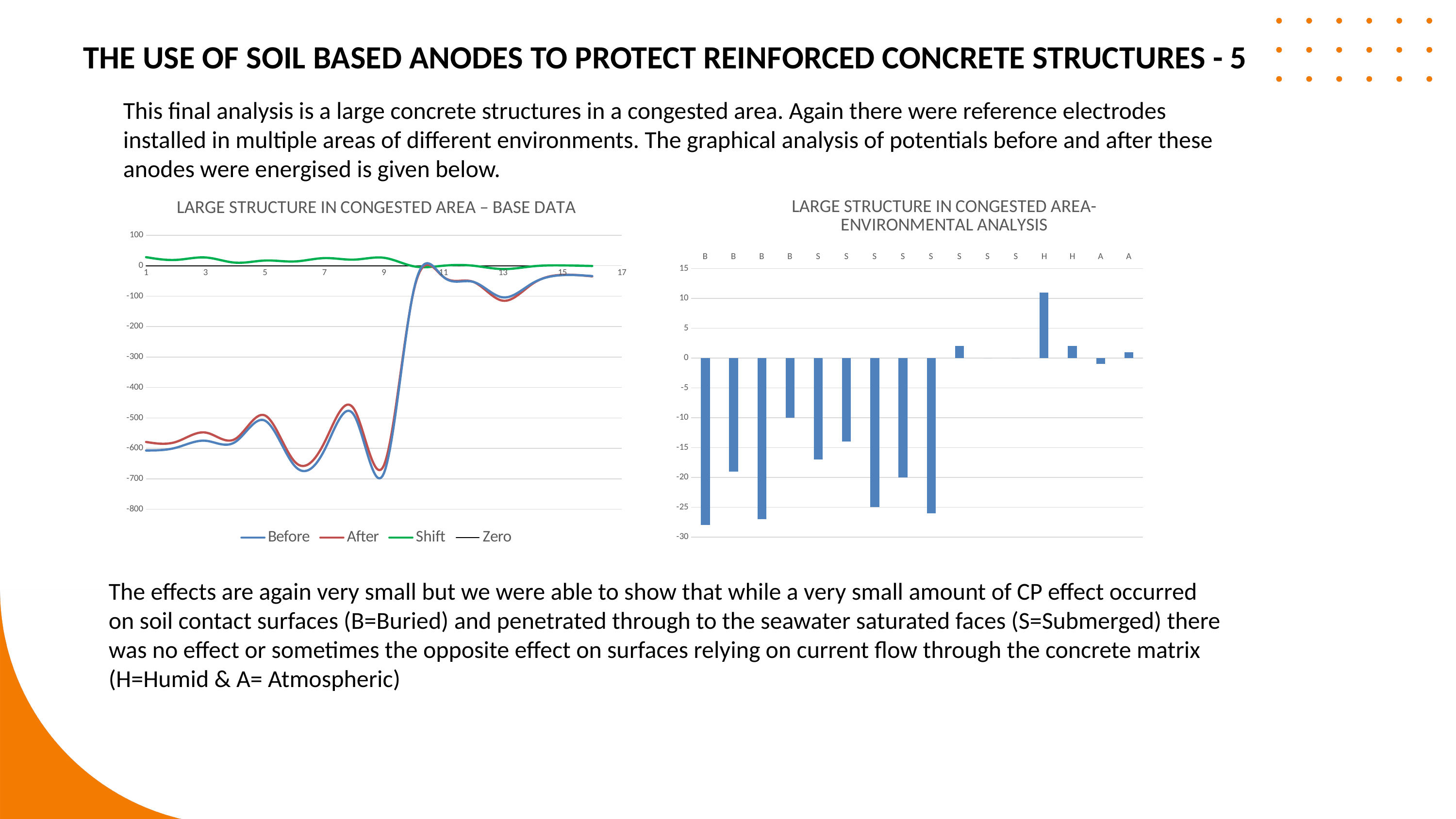
In the left chart (BASE DATA), what are the legend entries? Before, After, Shift, Zero What kind of chart is the left chart titled 'LARGE STRUCTURE IN CONGESTED AREA – BASE DATA'? Line chart In the right chart (ENVIRONMENTAL ANALYSIS), is the value of the first bar labelled H greater or less than 10? greater In the left chart (BASE DATA), does the Before series rise or fall between x = 9 and x = 11? Rise In the right chart (ENVIRONMENTAL ANALYSIS), which is larger: the value of the second bar labelled B or the fourth bar labelled B? The fourth bar labelled B In the right chart (ENVIRONMENTAL ANALYSIS), how many bars are labelled S? 8 In the right chart (ENVIRONMENTAL ANALYSIS), is the value of the first bar labelled B greater or less than -25? less In the right chart (ENVIRONMENTAL ANALYSIS), which bar has the highest value? The first bar labelled H In the left chart (BASE DATA), is the value of the Before series at x = 1 greater or less than -500? less In the left chart (BASE DATA), how many series does the legend list? 4 What kind of chart is the right chart titled 'LARGE STRUCTURE IN CONGESTED AREA- ENVIRONMENTAL ANALYSIS'? Bar chart